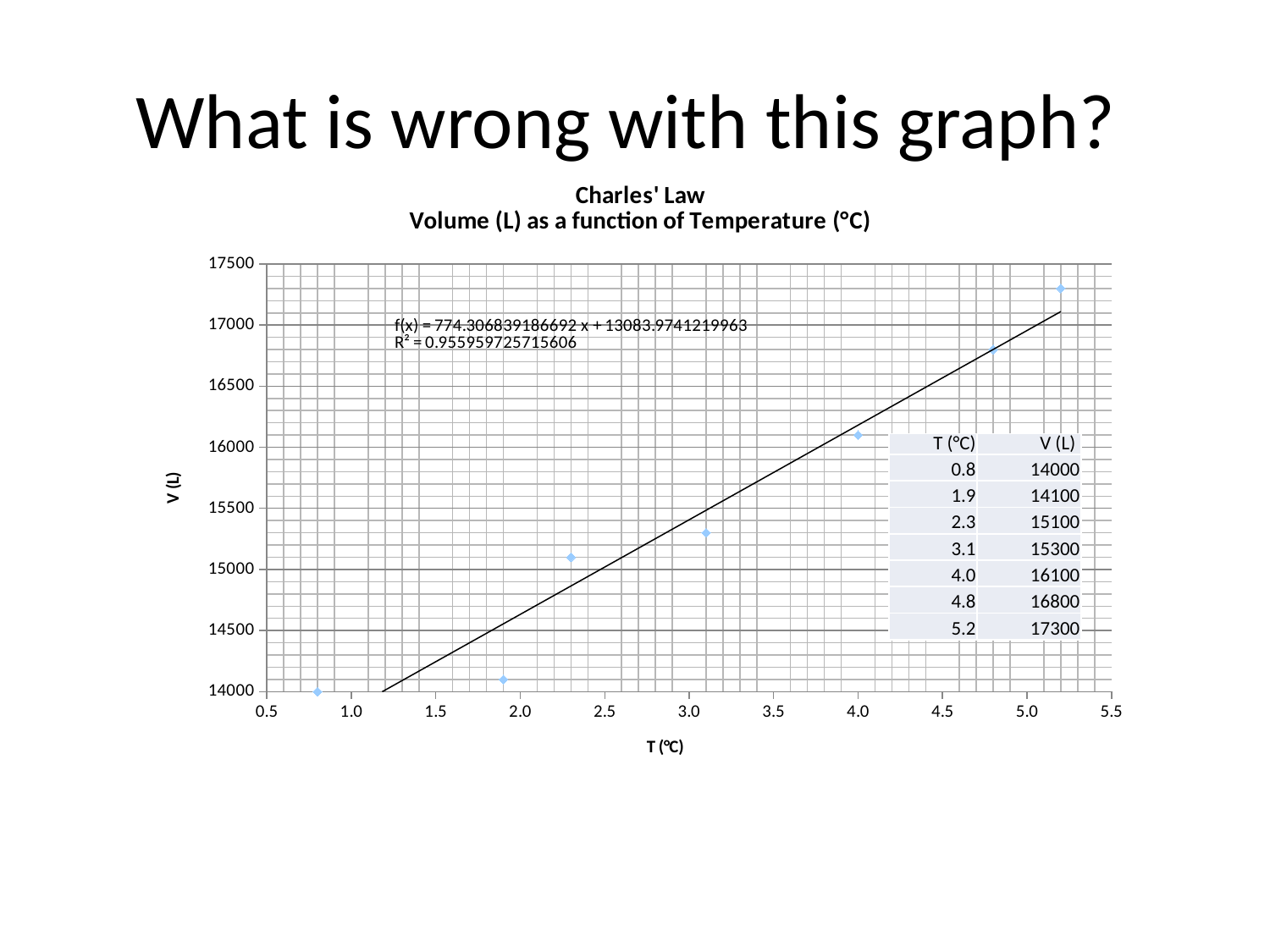
At which temperature is the volume highest? 5.2 Which has the larger volume, T = 1.9 °C or T = 3.1 °C? 3.1 What is the volume V (L) at T = 0.8 °C? 14000 What kind of chart is shown on the slide? scatter chart How many data points are plotted on the chart? 7 What is the title of the chart? Charles' Law Volume (L) as a function of Temperature (°C) What is the difference in volume between T = 5.2 °C and T = 4.0 °C? 1200 What is the volume V (L) at T = 4.8 °C? 16800 Do the volume values rise or fall as temperature increases along the x axis? rise What is the R² value shown for the trendline? 0.955959725715606 At which temperature is the volume lowest? 0.8 What is the volume V (L) at T = 2.3 °C? 15100